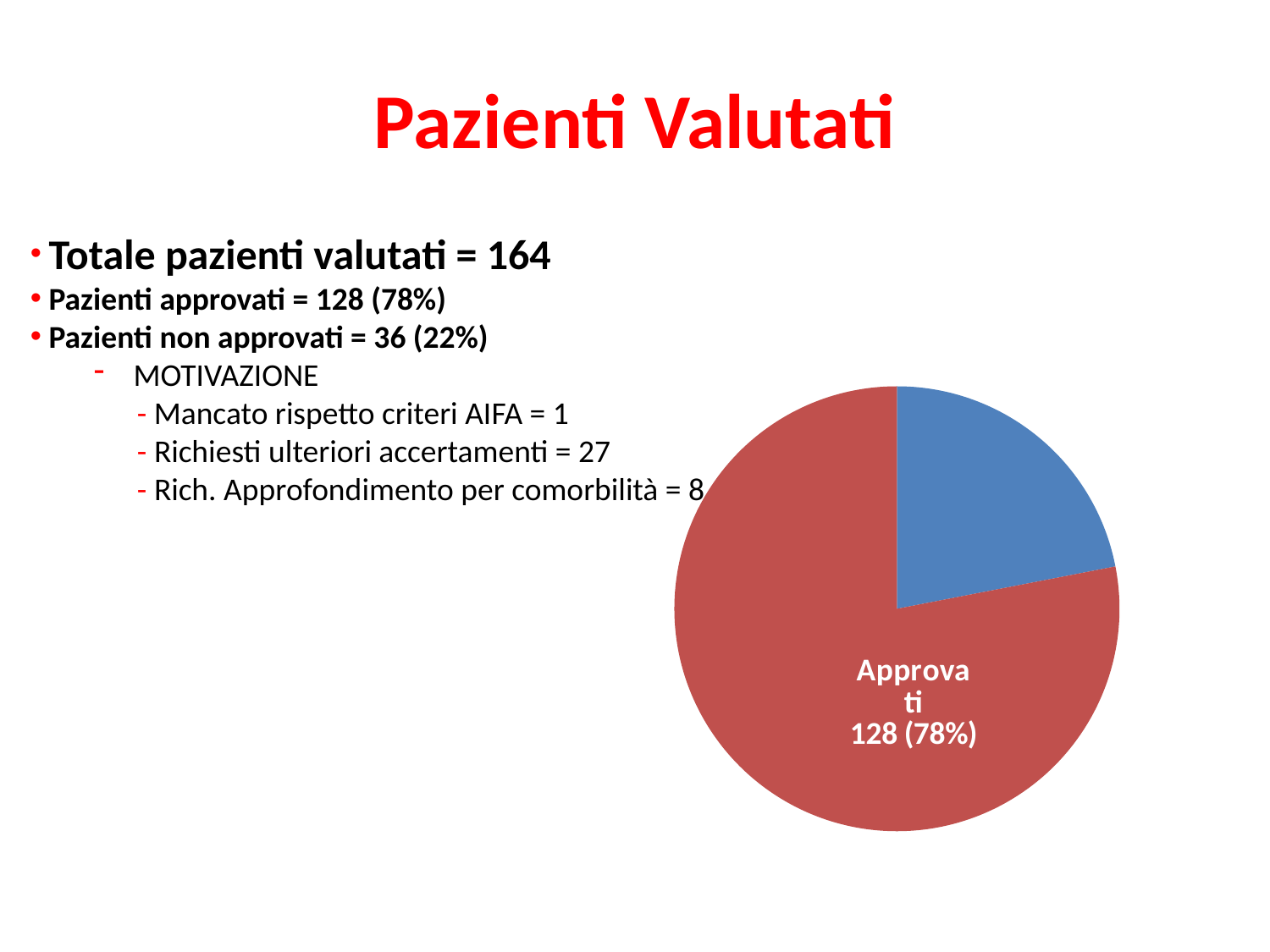
What percentage share of the pie does the 'Approvati' slice represent? 78% What colour is the 'Approvati' slice in the pie chart? red What value is printed on the 'Approvati' slice of the pie chart? 128 (78%) Which slice of the pie chart has a data label printed on it? Approvati Is the share of the 'Approvati' slice greater or less than 50%? greater What type of chart is shown on the slide? pie chart How many slices does the pie chart have? 2 Which slice of the pie chart is the largest? Approvati Is the 'Approvati' slice larger or smaller than the other slice of the pie chart? larger